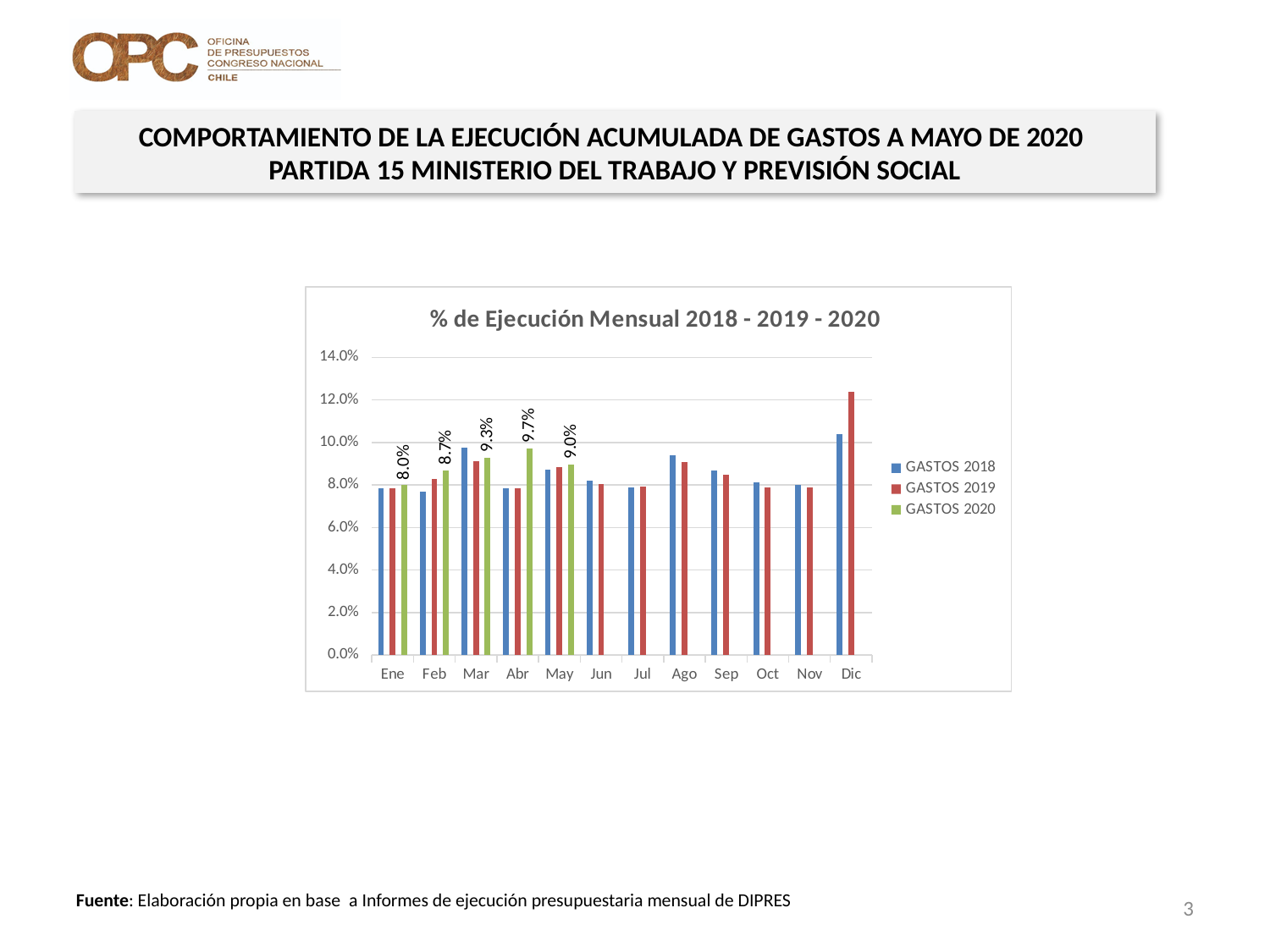
Which month has the highest value for GASTOS 2019? Dic Is the value for GASTOS 2018 in Ago greater or less than 8.0%? greater Which month has the lowest value for GASTOS 2020? Ene Which month has the highest value for GASTOS 2020? Abr What is the value for GASTOS 2020 in Ene? 8.0% What is the value for GASTOS 2020 in Abr? 9.7% Is the value for GASTOS 2019 in Dic greater or less than 12.0%? greater For GASTOS 2020, which is larger: Feb or Mar? Mar What is the value for GASTOS 2020 in Mar? 9.3% How many series does the legend list? 3 How many months are shown on the x axis? 12 What is the difference between the GASTOS 2020 values for Abr and Ene? 1.7 percentage points